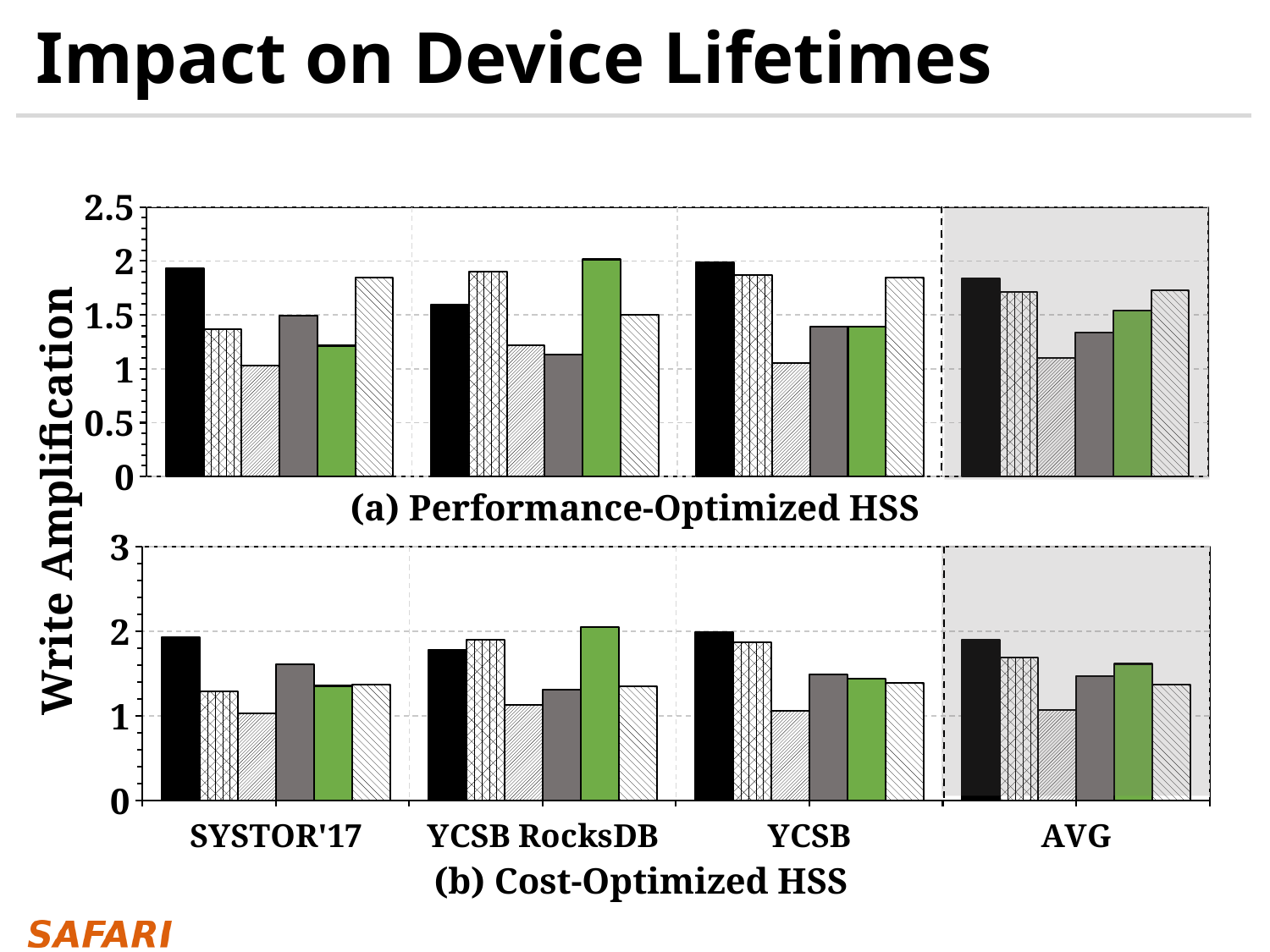
What is the highest tick value shown on the y axis of the (a) Performance-Optimized HSS chart? 2.5 In the (b) Cost-Optimized HSS chart, is the solid black bar for YCSB greater or less than 1? greater In the (a) Performance-Optimized HSS chart, which bar is the tallest in the YCSB RocksDB group? the solid green bar In the (a) Performance-Optimized HSS chart, is the solid green bar for YCSB RocksDB greater or less than 1.5? greater In the (a) Performance-Optimized HSS chart, for SYSTOR'17, which is larger: the solid black bar or the solid gray bar? the solid black bar In the (b) Cost-Optimized HSS chart, for YCSB RocksDB, which is larger: the solid black bar or the solid green bar? the solid green bar In the (b) Cost-Optimized HSS chart, is the solid gray bar for AVG greater or less than 2? less In the (a) Performance-Optimized HSS chart, how many bars are plotted for the SYSTOR'17 category? 6 What is the label on the shared y axis of the two charts? Write Amplification What kind of chart is used in panel (a) Performance-Optimized HSS? bar chart How many categories are shown along the x axis of the (b) Cost-Optimized HSS chart? 4